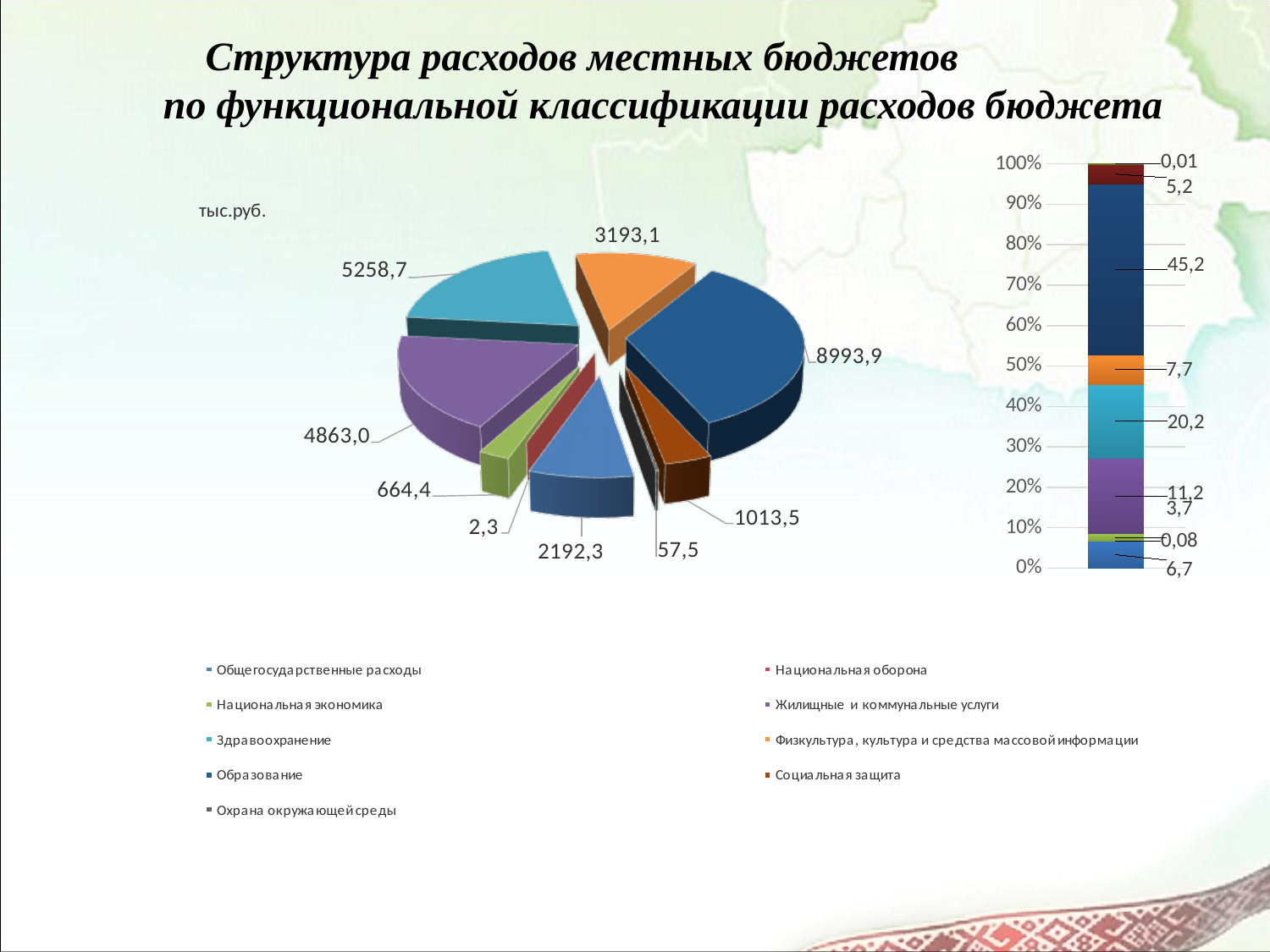
What kind of chart is the chart on the left of the slide? pie chart In the pie chart, which category has the smallest value? Национальная оборона In the pie chart, what is the value for Образование? 8993,9 How many categories does the legend list? 9 In the pie chart, which is larger: Физкультура, культура и средства массовой информации or Общегосударственные расходы? Физкультура, культура и средства массовой информации In the stacked bar chart, what is the value of the largest segment (Образование)? 45,2 What kind of chart is the chart on the right of the slide? stacked bar chart In the pie chart, what is the value for Здравоохранение? 5258,7 In the pie chart, what is the value for Жилищные и коммунальные услуги? 4863,0 In the pie chart, what is the difference between the values for Образование and Здравоохранение? 3735,2 In the pie chart, which category has the largest slice? Образование In the pie chart, what is the value for Социальная защита? 1013,5